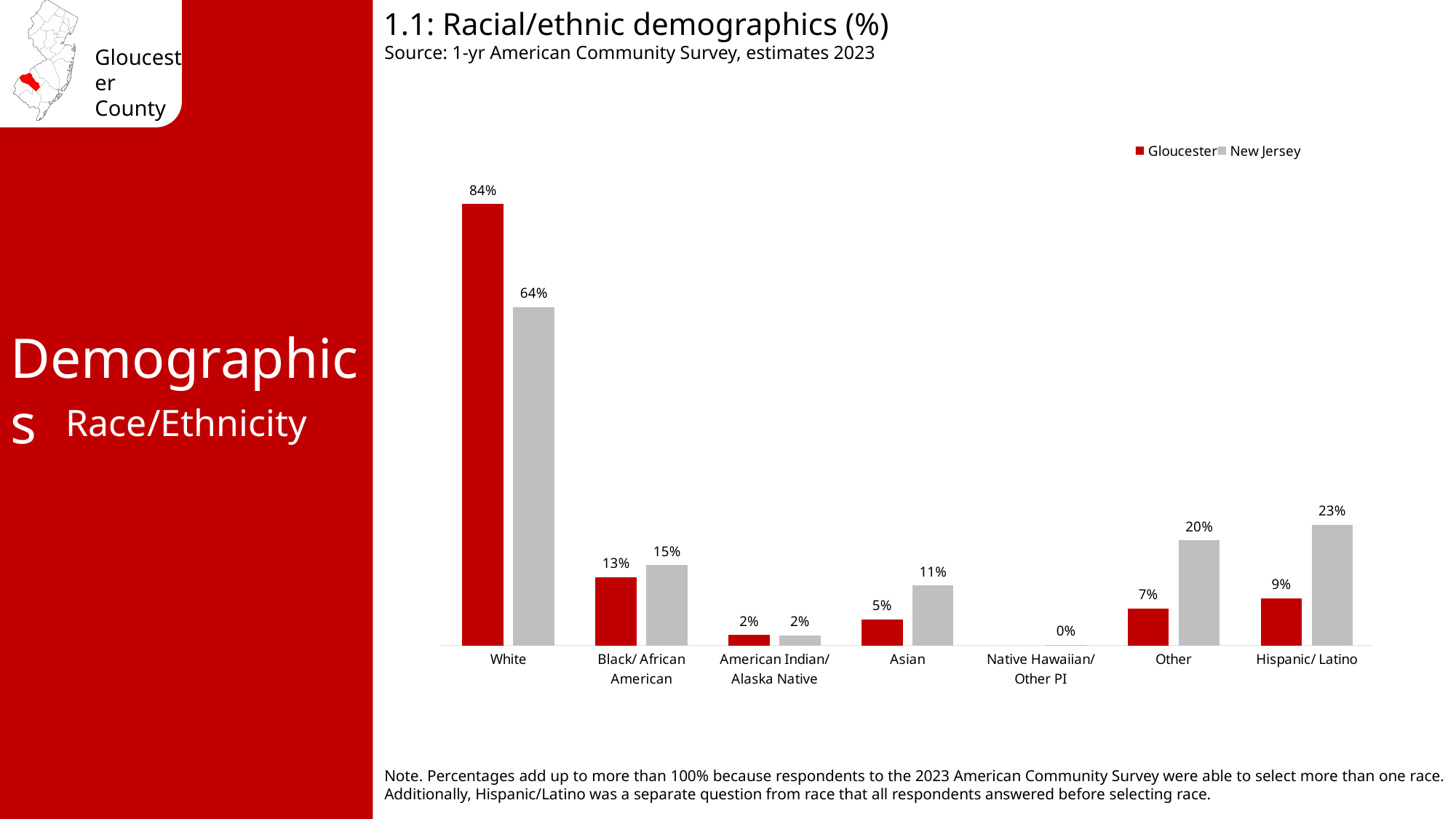
What colour represents Gloucester in the legend? Red What is the New Jersey value for Other? 20% Which category has the lowest New Jersey value? Native Hawaiian/ Other PI What is the Gloucester value for White? 84% How many series does the legend list? 2 What is the New Jersey value for Hispanic/ Latino? 23% Which category has the highest Gloucester value? White What kind of chart is shown on the slide? Bar chart For Asian, which is larger: the Gloucester value or the New Jersey value? New Jersey What is the difference between the Gloucester and New Jersey values for White? 20 percentage points How many racial/ethnic categories are shown on the x axis? 7 What is the Gloucester value for Asian? 5%